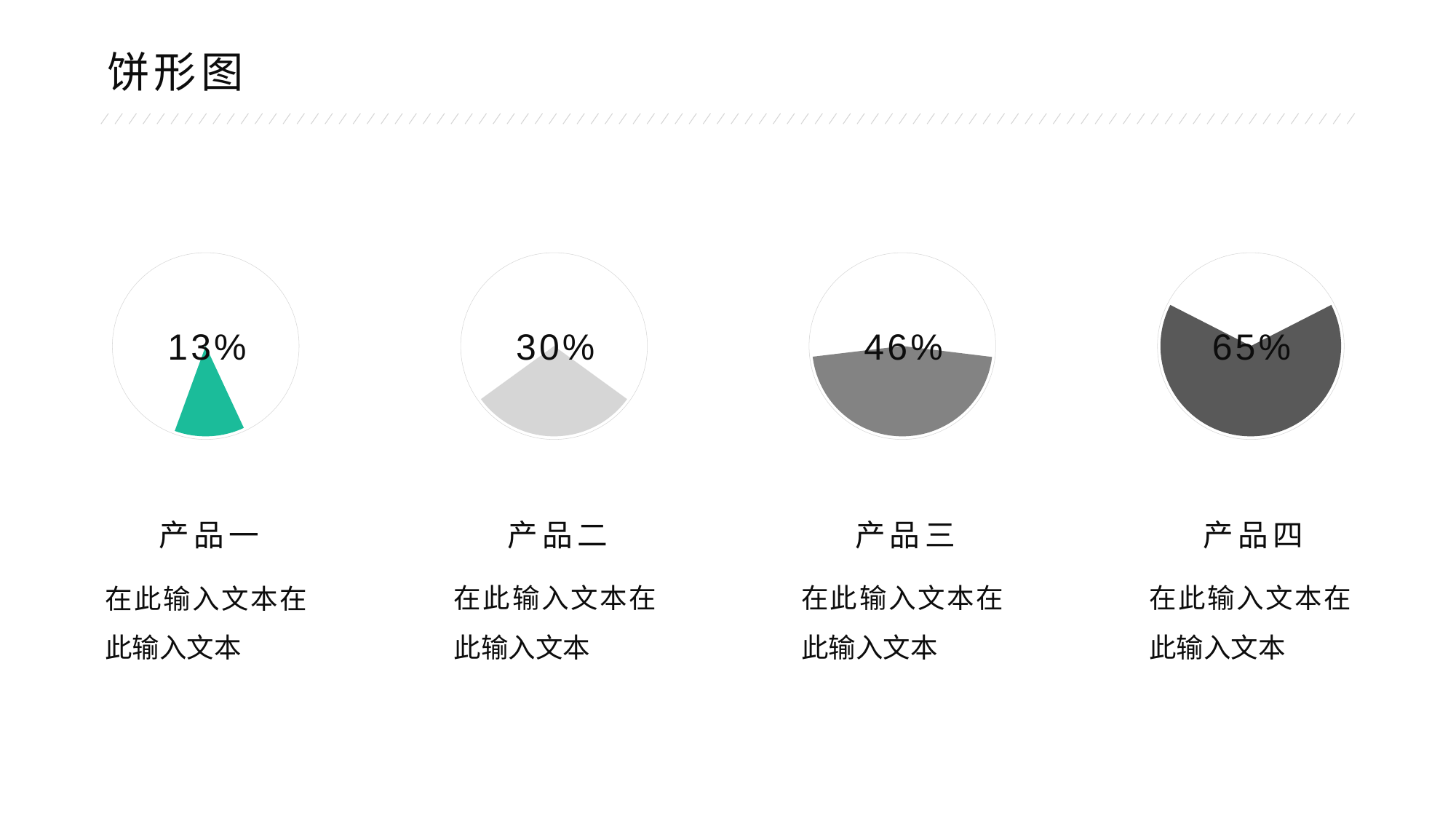
What is the difference between the percentages shown for 产品四 and 产品一? 52% What is the difference between the percentages shown for 产品三 and 产品二? 16% What percentage is shown on the pie chart for 产品二? 30% What percentage is shown on the pie chart for 产品三? 46% Which is larger, the percentage for 产品二 or the percentage for 产品三? 产品三 What percentage is shown on the pie chart for 产品一? 13% What percentage is shown on the pie chart for 产品四? 65% How many pie charts are shown on the slide? 4 What is the title of the slide? 饼形图 Which product has the highest percentage across the four pie charts? 产品四 What kind of chart is used for each product on the slide? Pie chart Which product has the lowest percentage across the four pie charts? 产品一